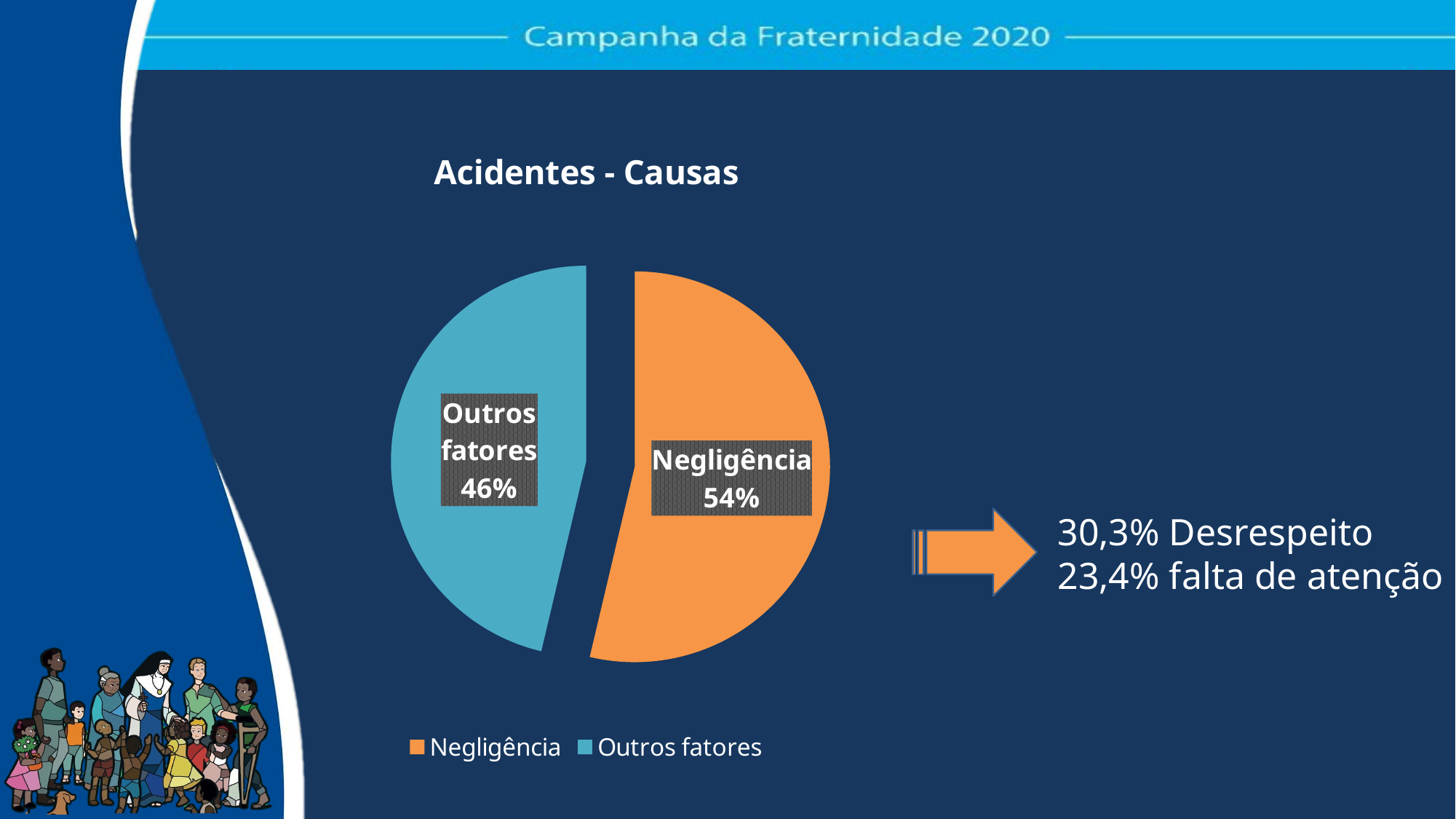
Which slice is the smallest? Outros fatores How many slices does the pie chart have? 2 How many entries does the legend list? 2 Which slice is the largest? Negligência What percentage of the pie is Negligência? 54% What is the share of the pie taken by Outros fatores? 46% What is the title of the chart? Acidentes - Causas What colour is the Negligência slice? orange What kind of chart is shown on the slide? pie chart Which is larger, Negligência or Outros fatores? Negligência What is the difference in percentage points between Negligência and Outros fatores? 8 What percentage of the pie is Outros fatores? 46%